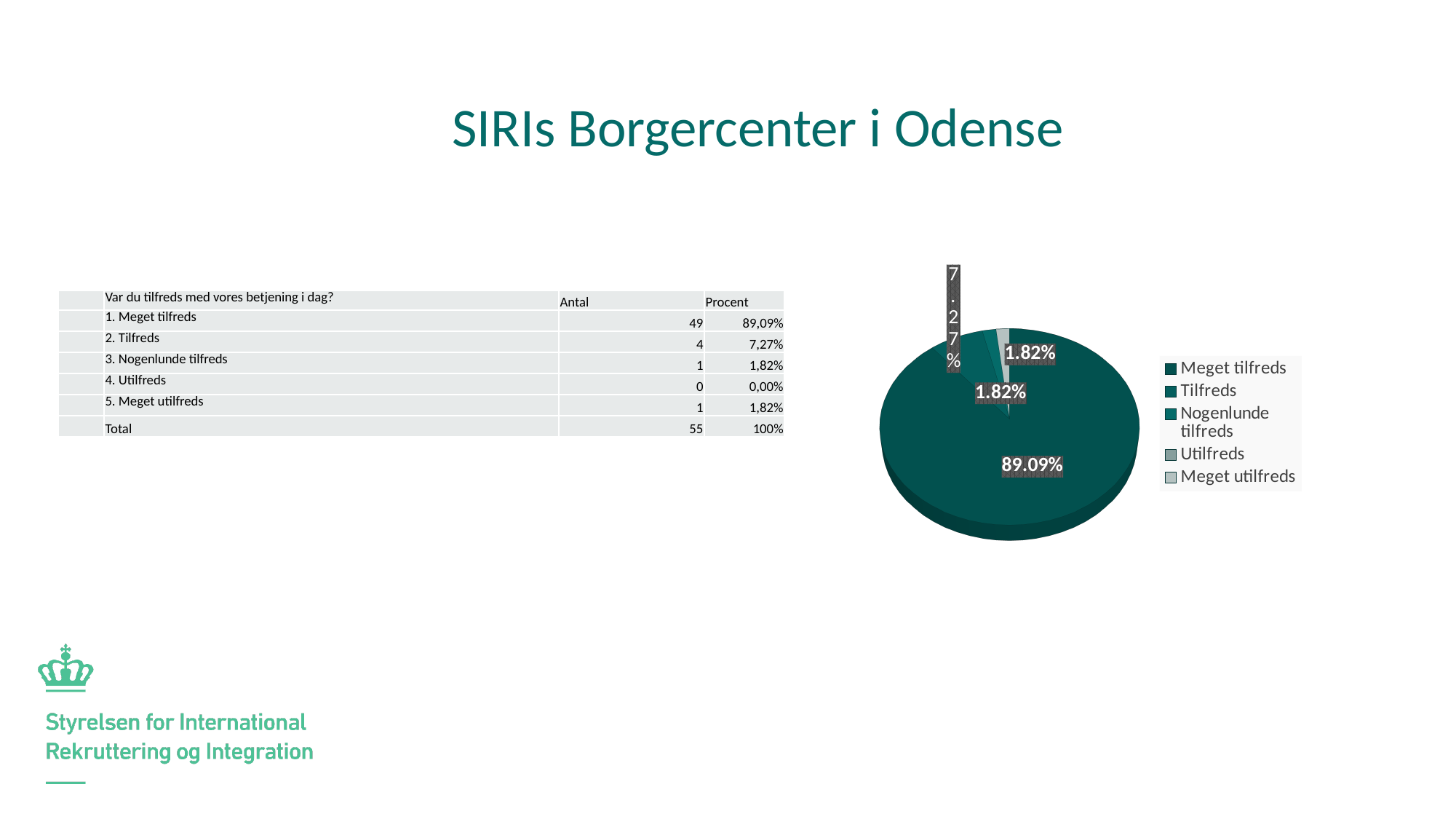
Which legend entry in the pie chart is listed first? Meget tilfreds How many entries does the legend of the pie chart list? 5 What kind of chart is shown on the slide? pie chart Which category has the largest slice in the pie chart? Meget tilfreds What is the difference in percentage points between the Meget tilfreds slice and the Tilfreds slice in the pie chart? 81.82 Is the share of the Meget tilfreds slice in the pie chart greater or less than 50%? greater What share of the pie chart does the Meget utilfreds slice represent? 1.82% What share of the pie chart does the Nogenlunde tilfreds slice represent? 1.82% What share of the pie chart does the Meget tilfreds slice represent? 89.09% Which legend entry in the pie chart is listed last? Meget utilfreds Which of the two slices is larger in the pie chart: Meget tilfreds or Tilfreds? Meget tilfreds